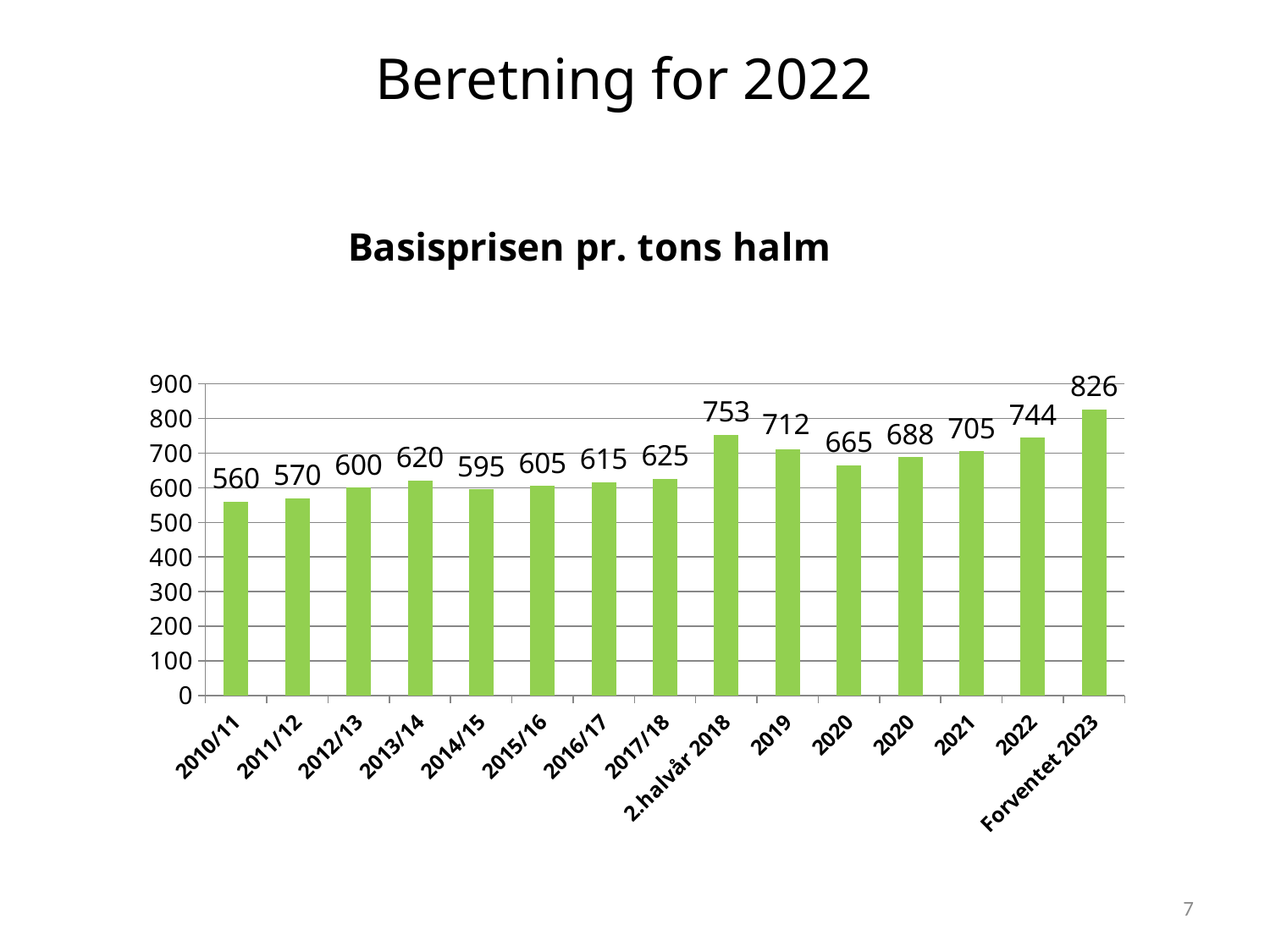
What is the value for 2022? 744 Which category has the highest value? Forventet 2023 How many bars are shown in the chart? 15 What is the value for 2010/11 in the chart 'Basisprisen pr. tons halm'? 560 What is the title of the chart? Basisprisen pr. tons halm What is the difference between the values for 2022 and 2021? 39 What kind of chart is shown on the slide? Bar chart What is the value for Forventet 2023? 826 Which is larger, the value for 2013/14 or the value for 2014/15? 2013/14 Which category has the lowest value? 2010/11 What is the value for 2.halvår 2018? 753 What is the difference between the values for 2.halvår 2018 and 2019? 41